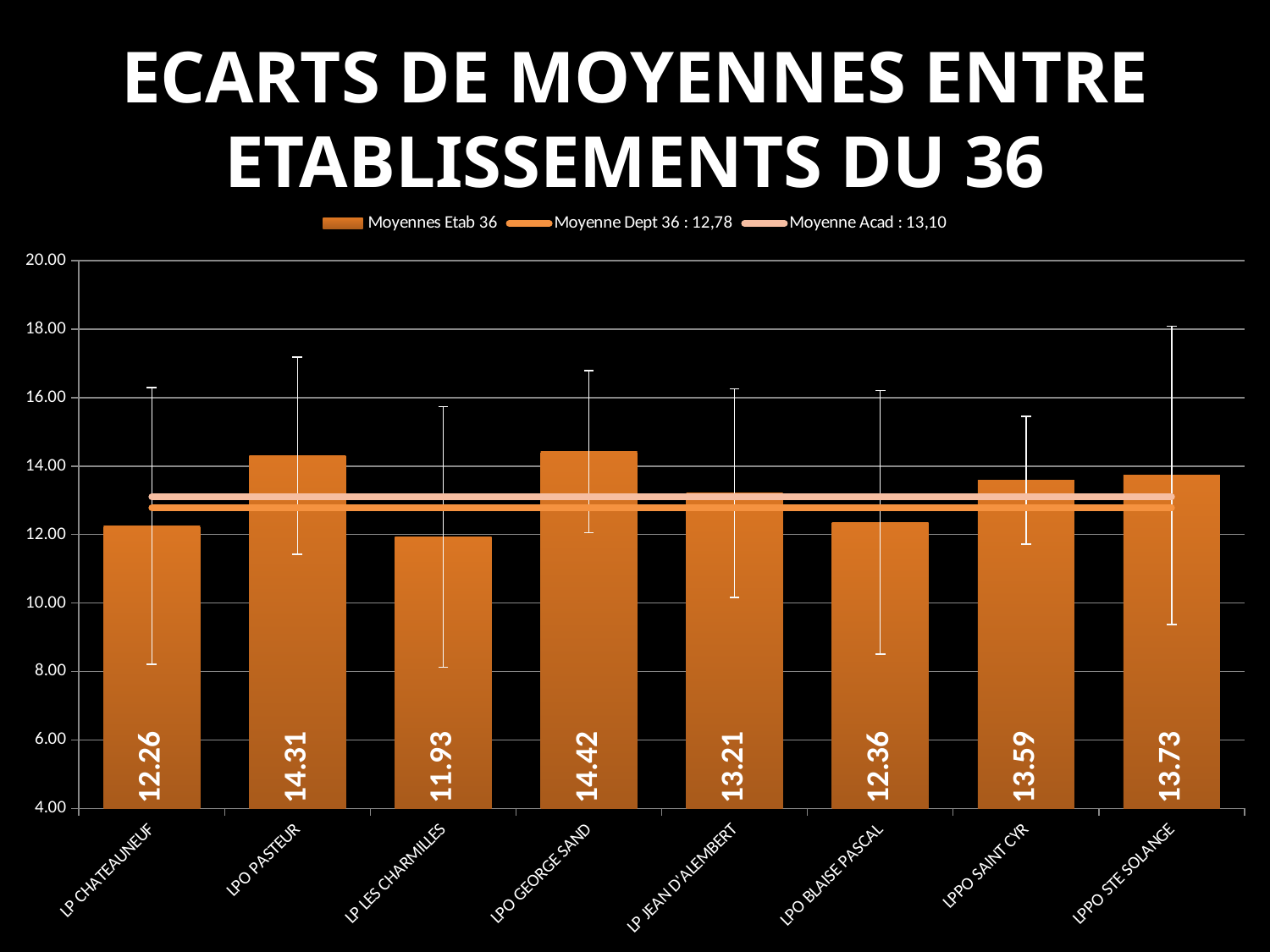
What kind of chart is shown? bar chart What is the value for LP LES CHARMILLES? 11.93 What is the difference between the values for LPO GEORGE SAND and LP LES CHARMILLES? 2.49 Is the value for LPPO STE SOLANGE greater or less than 14.00? less Which establishment has the lowest average? LP LES CHARMILLES Which is larger, the value for LP CHATEAUNEUF or the value for LPO BLAISE PASCAL? LPO BLAISE PASCAL How many establishments are shown on the x axis? 8 What value does the legend give for Moyenne Dept 36? 12,78 How many series does the legend list? 3 What is the value for LPPO SAINT CYR? 13.59 Which establishment has the highest average? LPO GEORGE SAND What is the value for LPO PASTEUR? 14.31